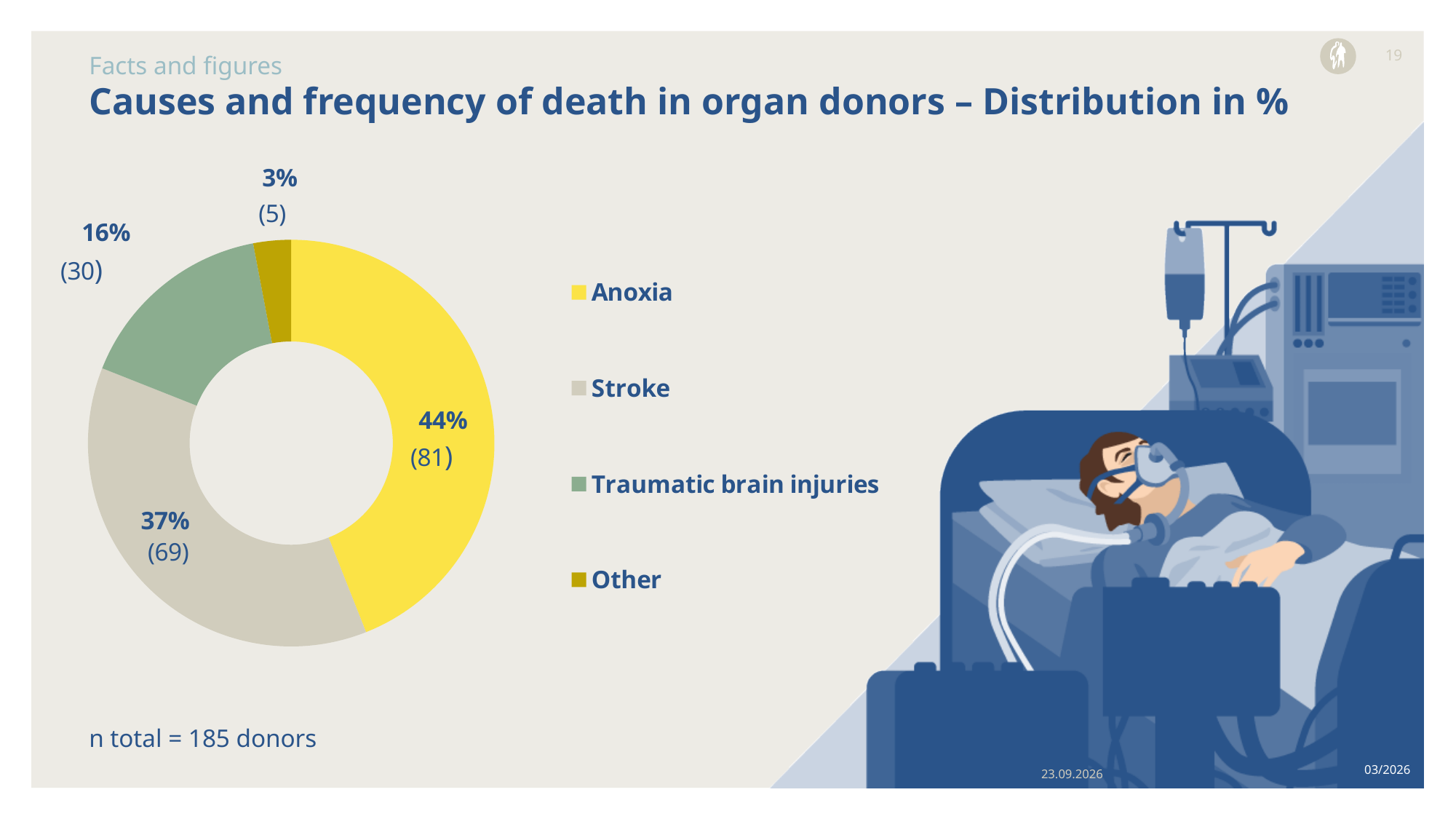
What is the total number of donors stated on the slide? 185 donors Which has a larger share, Stroke or Traumatic brain injuries? Stroke How many more donors died from Traumatic brain injuries than from Other causes? 25 What percentage of organ donor deaths is attributed to Anoxia? 44% Which cause of death accounts for the smallest share of organ donors? Other How many donors fall into the Other category? 5 How many donors died from Stroke, according to the count shown in parentheses? 69 What is the difference in percentage points between Anoxia and Stroke? 7 What kind of chart is shown on the slide? Pie chart (doughnut) Which cause of death accounts for the largest share of organ donors? Anoxia How many categories does the chart show? 4 What percentage of organ donor deaths is attributed to Traumatic brain injuries? 16%